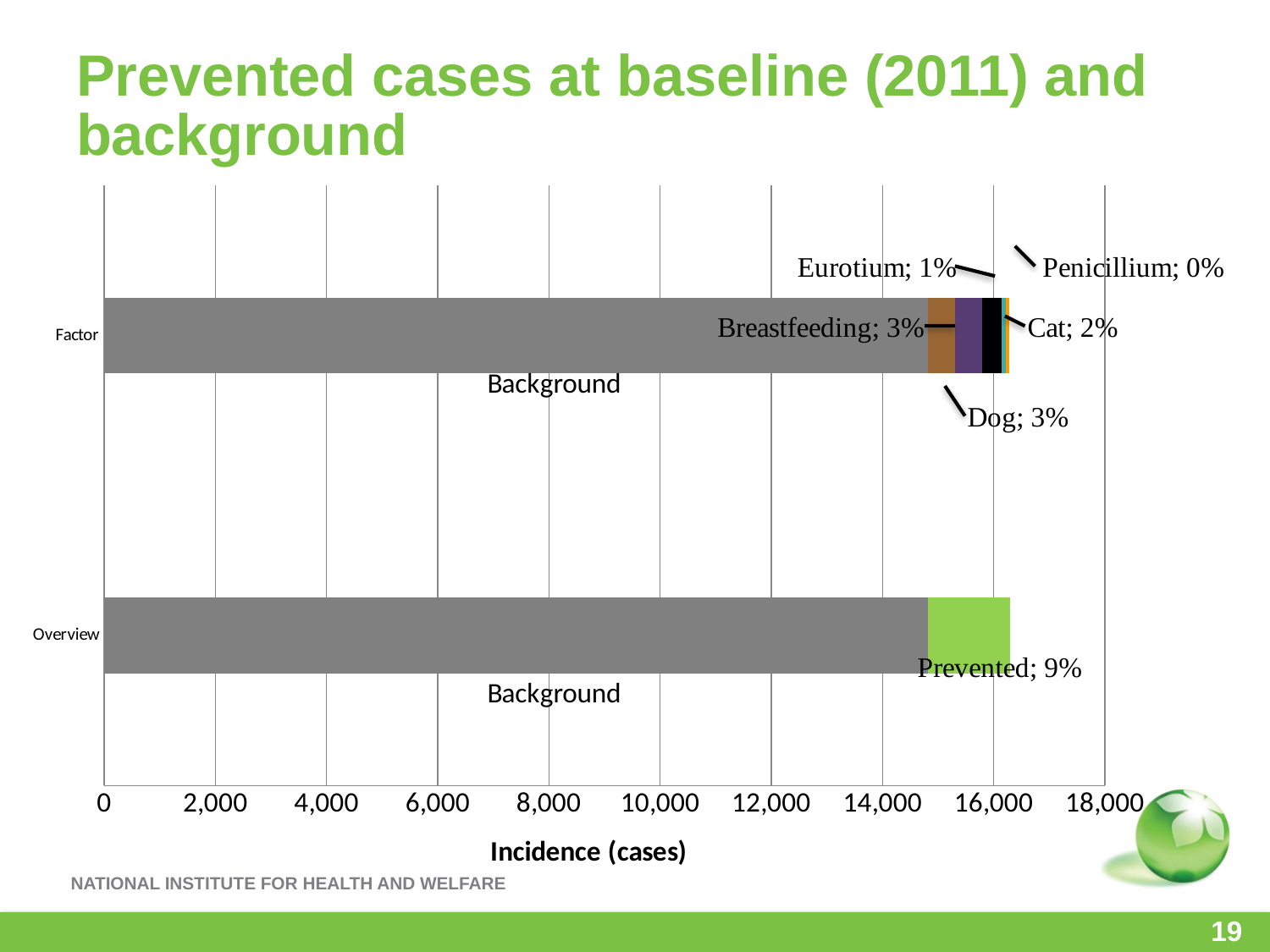
Is the Background value in the Overview bar greater or less than 16,000? less What percentage is labelled for Breastfeeding in the Factor bar? 3% What percentage is labelled for Prevented in the Overview bar? 9% What percentage is labelled for Eurotium in the Factor bar? 1% What is the title of the horizontal axis? Incidence (cases) Which labelled factor in the Factor bar has the lowest percentage? Penicillium What percentage is labelled for Dog in the Factor bar? 3% Which is larger in the Factor bar, the percentage for Breastfeeding or for Cat? Breastfeeding How many categories are shown on the vertical axis of the chart? 2 What percentage is labelled for Cat in the Factor bar? 2% What kind of chart is shown on the slide? Bar chart What percentage is labelled for Penicillium in the Factor bar? 0%